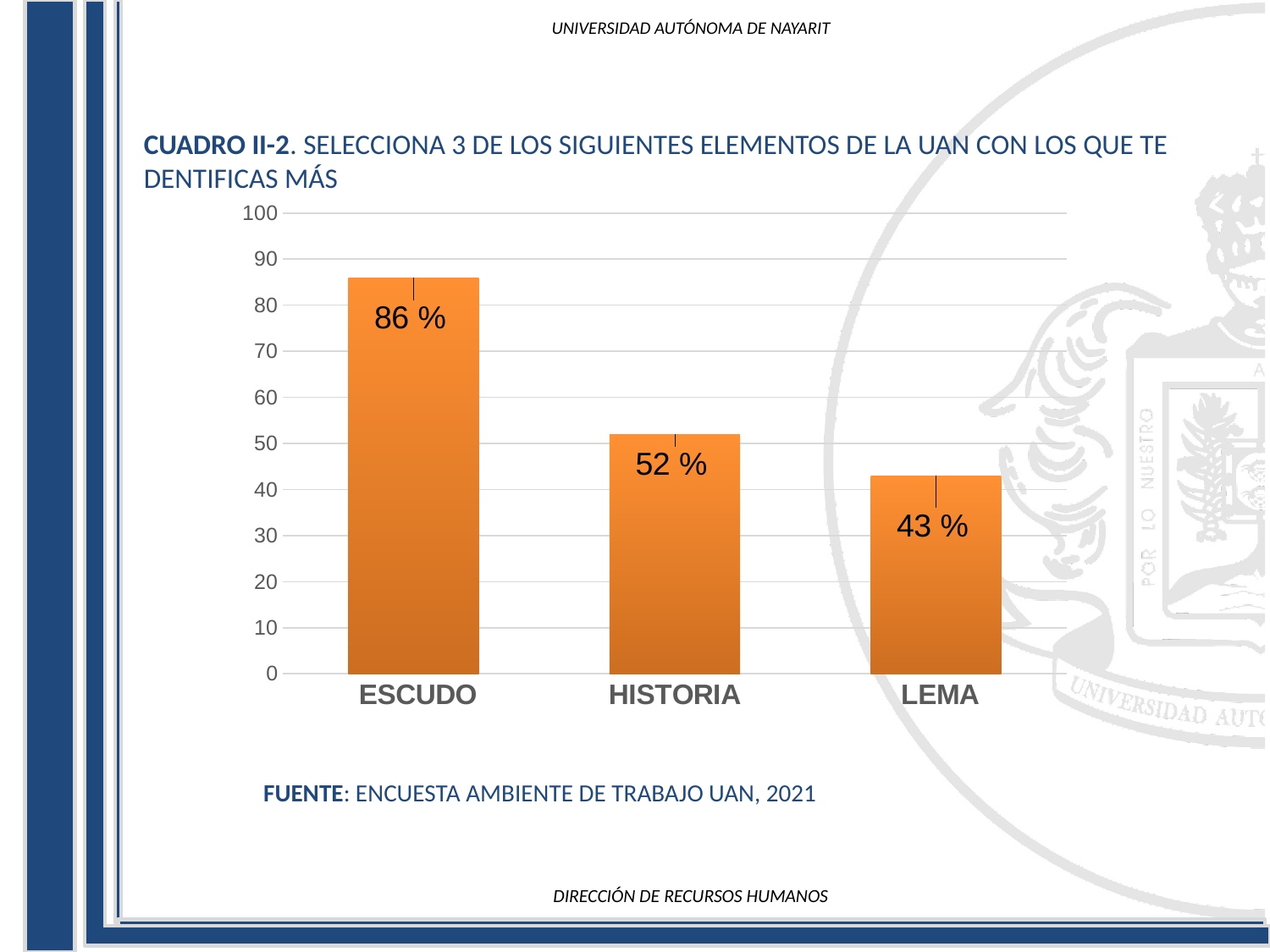
What is the value for ESCUDO? 86 % What is the difference between the values for ESCUDO and HISTORIA? 34 % Which category has the highest value? ESCUDO Is the value for LEMA greater or less than 50? less How many categories are shown on the x axis? 3 What is the value for HISTORIA? 52 % Which is larger, the value for HISTORIA or the value for LEMA? HISTORIA What is the difference between the values for HISTORIA and LEMA? 9 % What kind of chart is shown on the slide? bar chart What is the value for LEMA? 43 % Do the values rise or fall from left to right along the x axis? fall Which category has the lowest value? LEMA